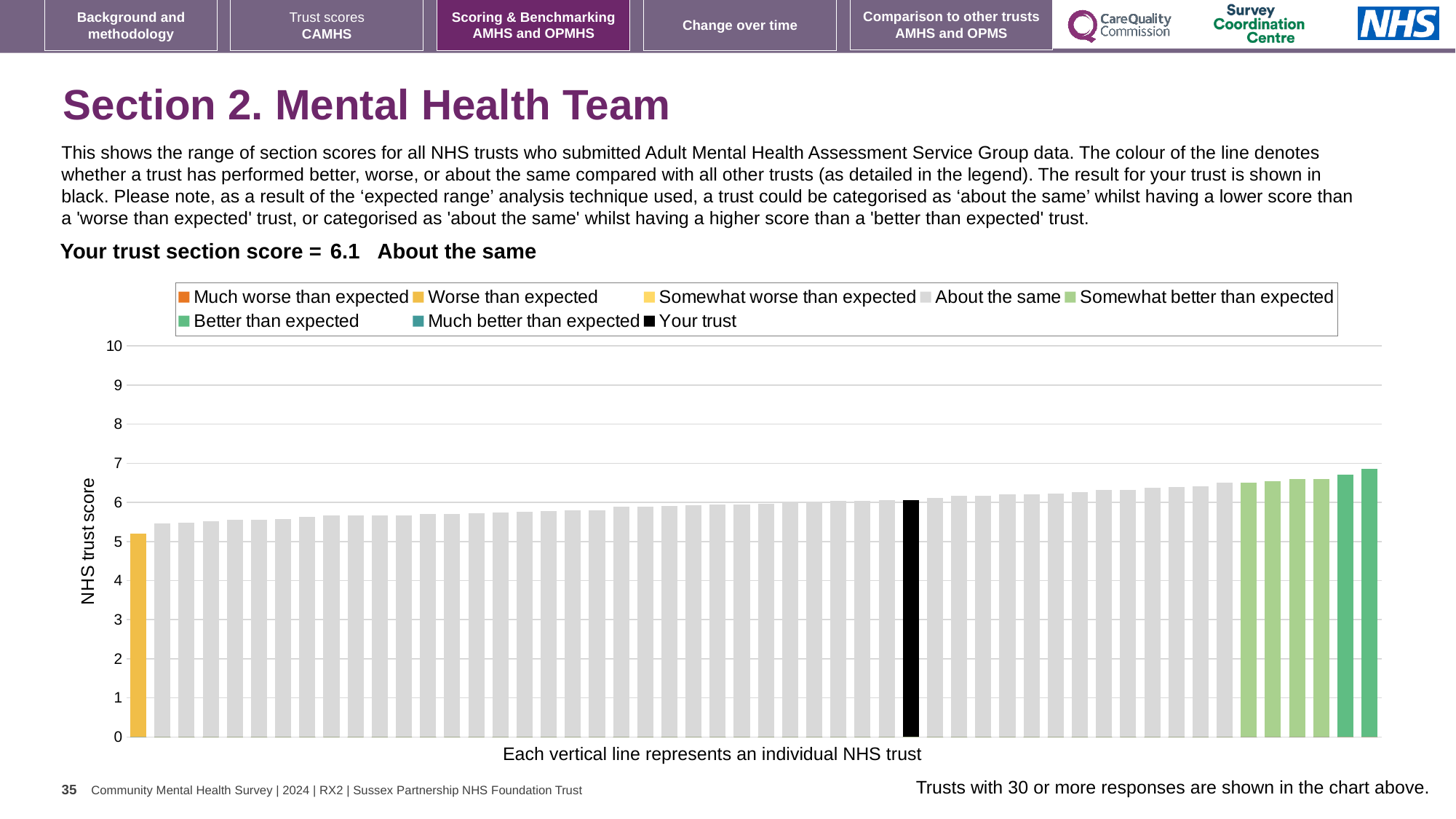
Do the bar values rise or fall from left to right along the x axis? Rise Is the value of the black 'Your trust' bar greater or less than 5? greater How many bars are coloured as 'Worse than expected'? 1 What kind of chart is shown on the slide? Bar chart How many entries does the chart legend list? 8 Which category is your trust placed in according to the slide? About the same What is the label on the vertical axis of the chart? NHS trust score What is the section score for your trust shown on the slide? 6.1 Which legend category does the lowest bar in the chart belong to? Worse than expected Is the value of the leftmost (yellow) bar greater or less than 6? less Which legend category does the highest bar in the chart belong to? Better than expected Is the value of the rightmost bar greater or less than 7? less